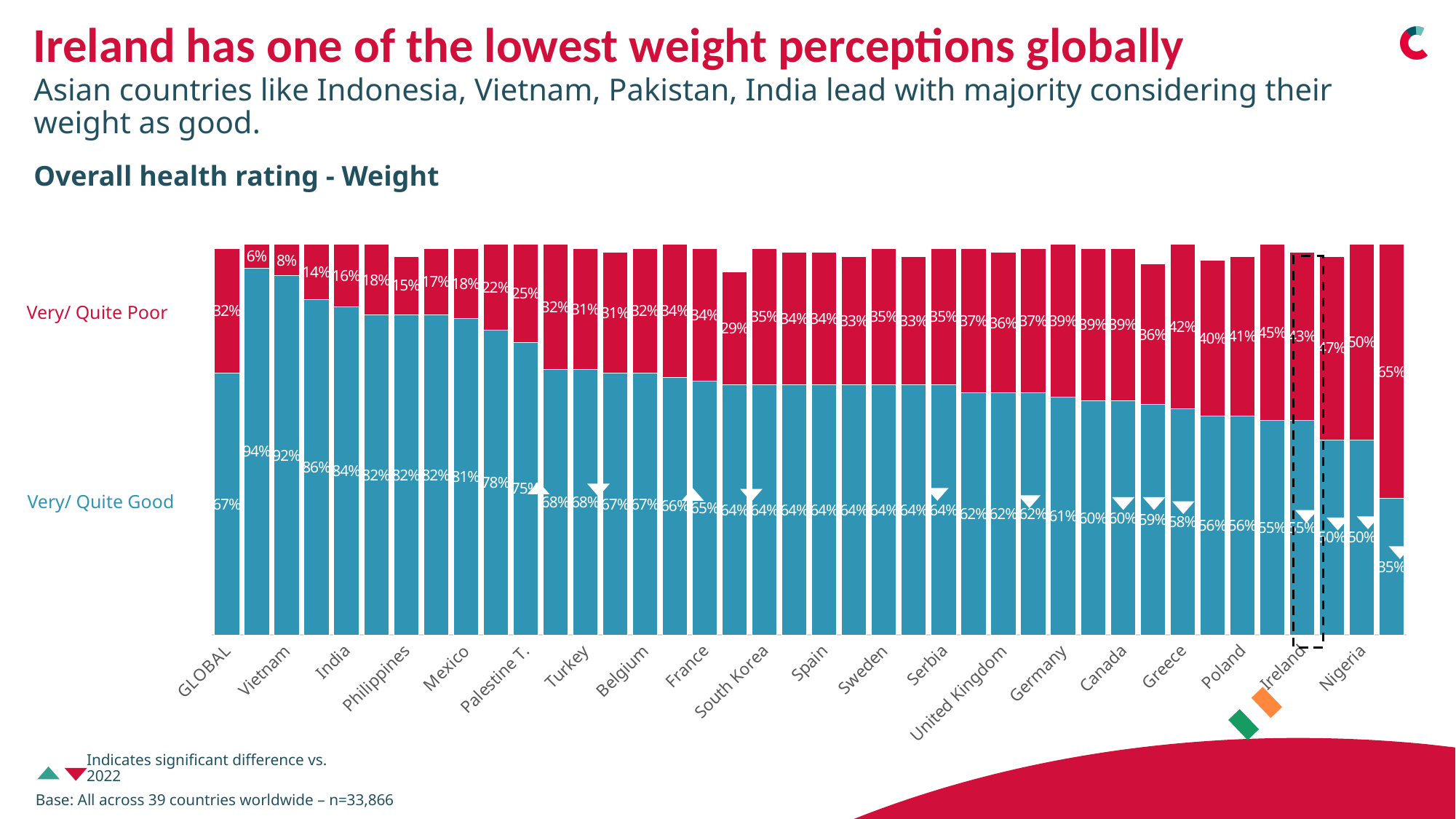
What is the Very/Quite Poor value for Greece? 42% What kind of chart is shown on the slide? Stacked bar chart What is the difference between the Very/Quite Good value for GLOBAL and for Ireland? 12 percentage points What is the Very/Quite Good value for Vietnam? 92% What is the title of the chart? Overall health rating - Weight Which has a higher Very/Quite Good value, India or Germany? India What is the Very/Quite Poor value for Ireland? 43% How many series does the chart show? 2 What is the Very/Quite Good value for Nigeria? 50% What is the Very/Quite Good value for Palestine T.? 75% Which has a higher Very/Quite Good value, Canada or Poland? Canada What is the Very/Quite Good value for GLOBAL? 67%